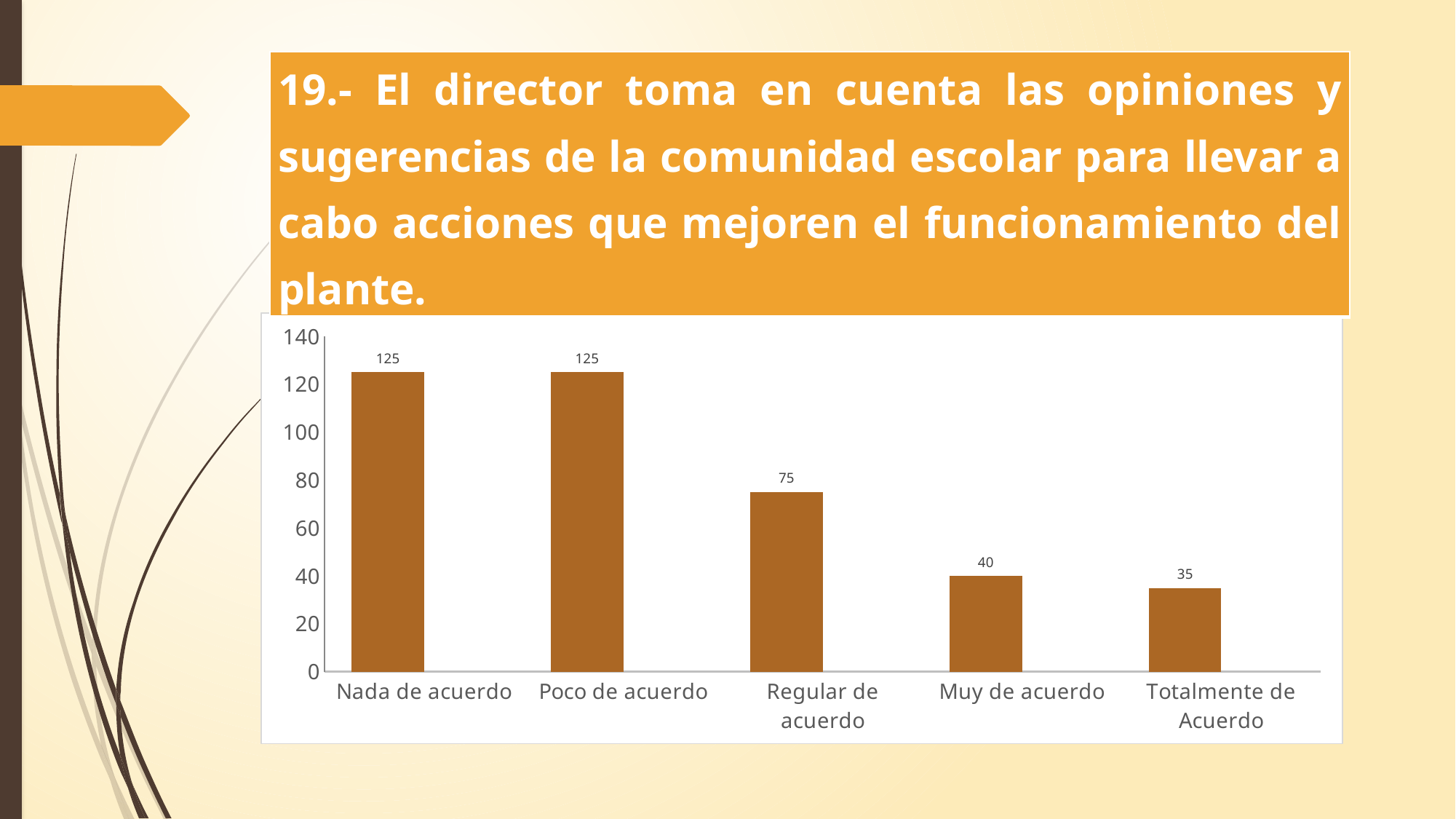
What is the value for Nada de acuerdo? 125 Which is larger, the value for Regular de acuerdo or the value for Muy de acuerdo? Regular de acuerdo What is the difference between the values for Poco de acuerdo and Regular de acuerdo? 50 What is the value for Muy de acuerdo? 40 What is the difference between the values for Muy de acuerdo and Totalmente de Acuerdo? 5 What kind of chart is shown on the slide? bar chart Is the value for Regular de acuerdo greater or less than 100? less What is the value for Regular de acuerdo? 75 Do the values rise or fall from left to right along the x axis? fall Which category has the lowest value? Totalmente de Acuerdo How many categories are shown on the x axis? 5 What is the value for Totalmente de Acuerdo? 35